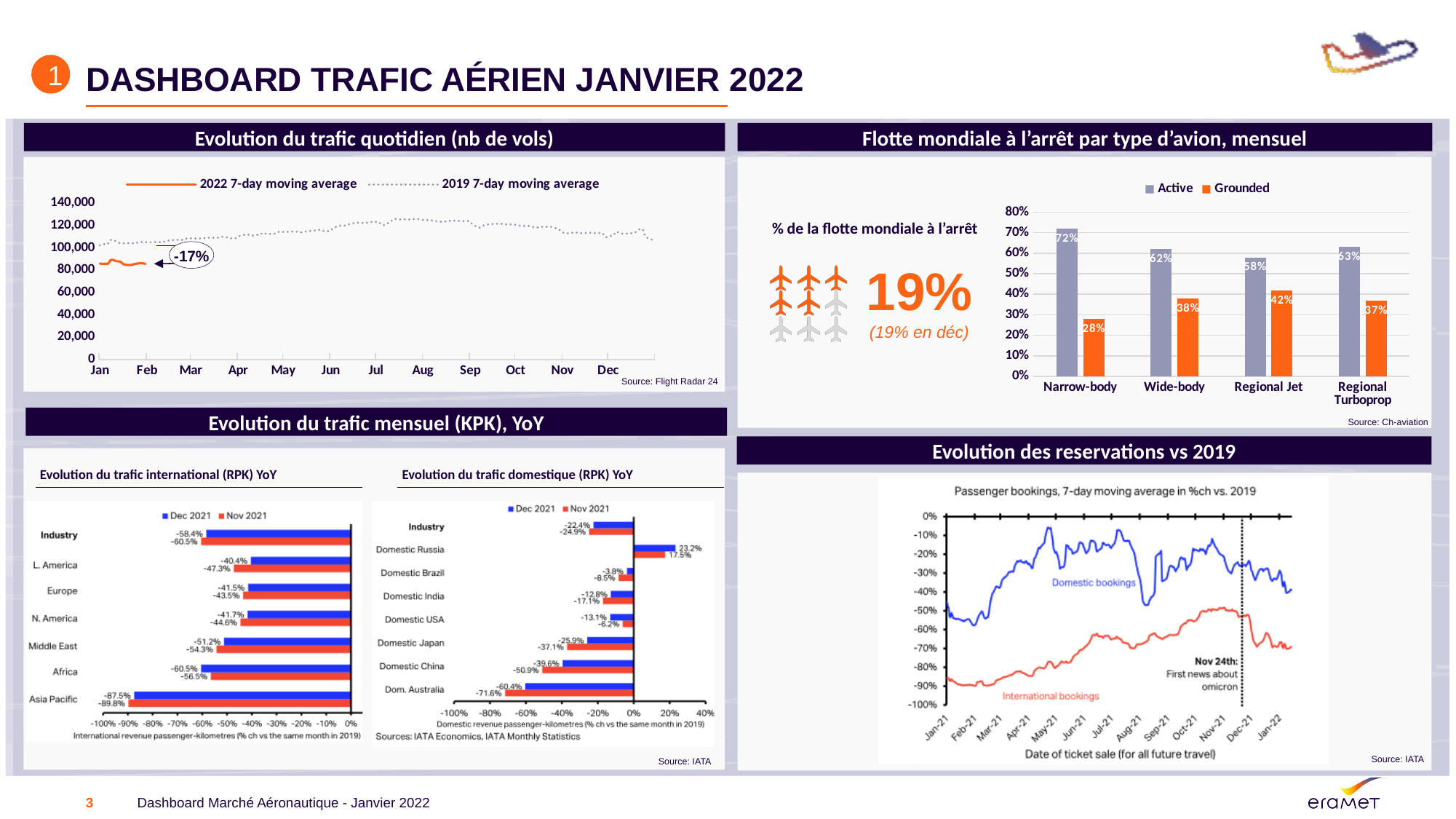
How many series does the legend of the 'Flotte mondiale à l'arrêt par type d'avion, mensuel' chart list? 2 In the 'Evolution du trafic domestique (RPK) YoY' chart, what is the difference between the Dec 2021 and Nov 2021 values for Domestic China? 11.3% In the 'Flotte mondiale à l'arrêt par type d'avion, mensuel' chart, which aircraft type has the highest Active share? Narrow-body In the 'Evolution du trafic international (RPK) YoY' chart, what is the Dec 2021 value for Asia Pacific? -87.5% How many categories are shown in the 'Evolution du trafic domestique (RPK) YoY' chart? 8 In the 'Flotte mondiale à l'arrêt par type d'avion, mensuel' chart, what is the Grounded value for Narrow-body? 28% In the 'Evolution du trafic quotidien (nb de vols)' chart, what percentage gap is annotated between the 2022 and 2019 7-day moving averages? -17% What kind of chart is 'Evolution du trafic quotidien (nb de vols)'? Line chart In the 'Evolution du trafic domestique (RPK) YoY' chart, what is the Dec 2021 value for Domestic Russia? 23.2% In the 'Evolution du trafic international (RPK) YoY' chart, which is larger for Africa: the Dec 2021 value or the Nov 2021 value? Nov 2021 In the 'Evolution du trafic international (RPK) YoY' chart, which region has the lowest Dec 2021 value? Asia Pacific In the 'Flotte mondiale à l'arrêt par type d'avion, mensuel' chart, what is the difference between the Active and Grounded values for Regional Jet? 16%